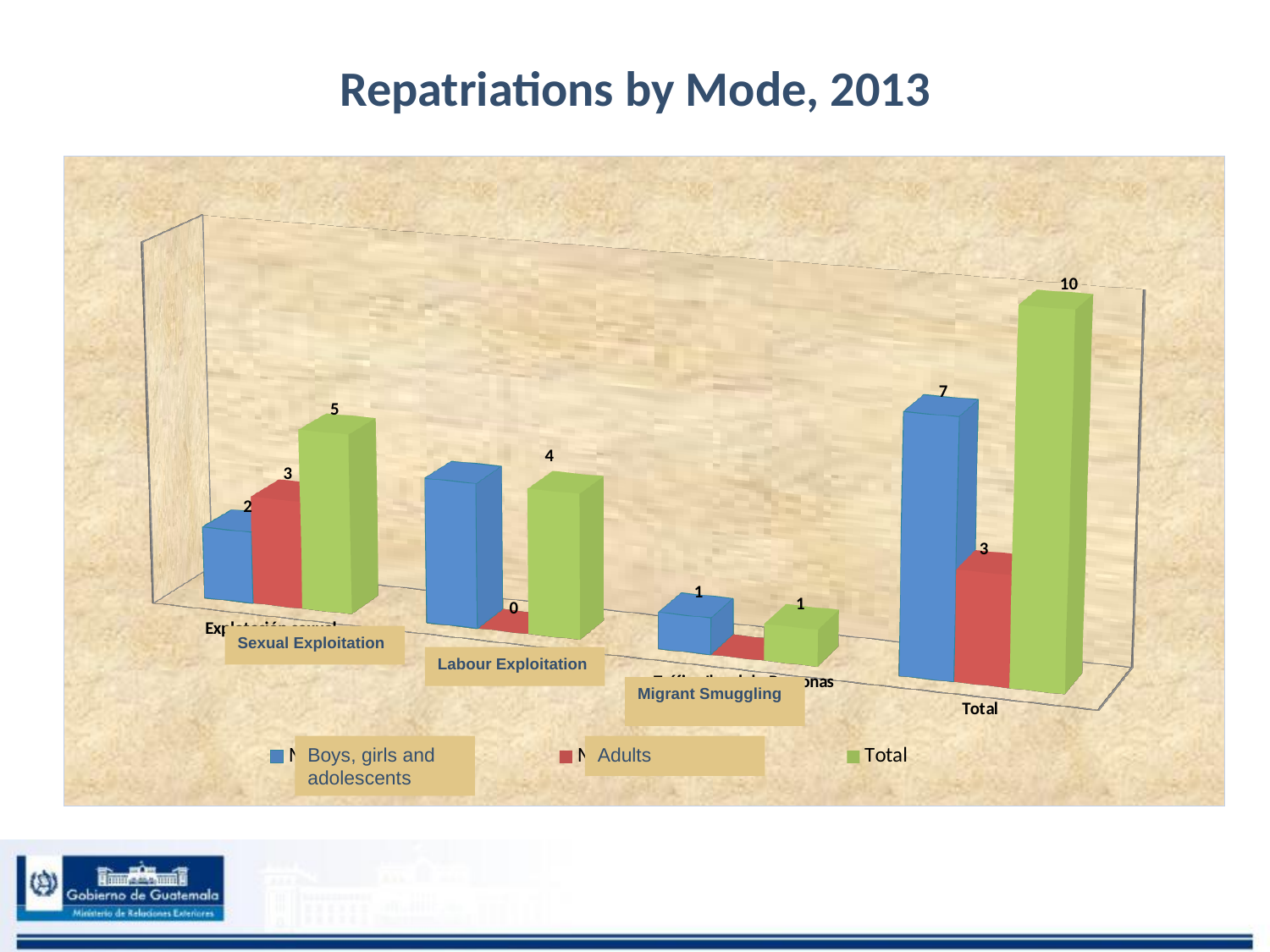
What is the Adults value for Labour Exploitation? 0 What is the Total value for Sexual Exploitation? 5 What kind of chart is shown on the slide? Bar chart What is the Boys, girls and adolescents value for the Total category? 7 For Sexual Exploitation, which is larger: the Boys, girls and adolescents value or the Adults value? Adults What is the difference between the Total values for Sexual Exploitation and Labour Exploitation? 1 Which category has the lowest value in the Total series? Migrant Smuggling What is the Total value for the Total category? 10 Excluding the Total category, which mode has the highest value in the Total series? Sexual Exploitation How many categories are shown along the x axis? 4 What is the title of the chart? Repatriations by Mode, 2013 How many series does the legend list? 3